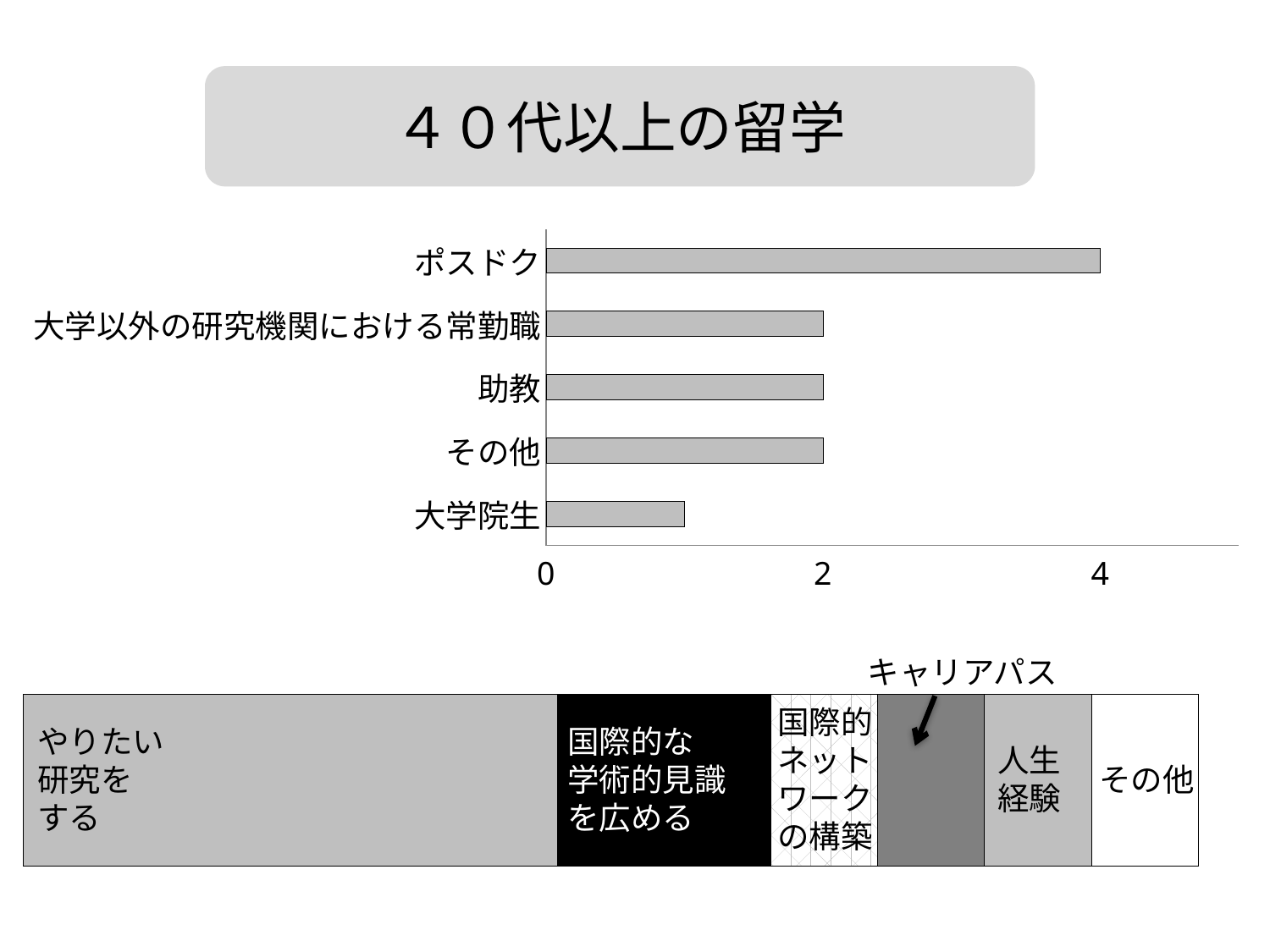
In the lower stacked bar, how many segments are there? 6 What kind of chart is the upper chart on the slide? bar chart In the upper bar chart, which is larger, the value for ポスドク or the value for 大学院生? ポスドク In the upper bar chart, which category has the lowest value? 大学院生 In the upper bar chart, what is the value for ポスドク? 4 In the upper bar chart, how many categories are plotted? 5 In the lower stacked bar, which segment is the largest? やりたい研究をする In the upper bar chart, what is the value for 大学以外の研究機関における常勤職? 2 In the upper bar chart, which category has the highest value? ポスドク In the upper bar chart, what is the difference between the values for ポスドク and その他? 2 In the upper bar chart, is the value for 大学院生 greater or less than 2? less In the upper bar chart, what is the value for 助教? 2